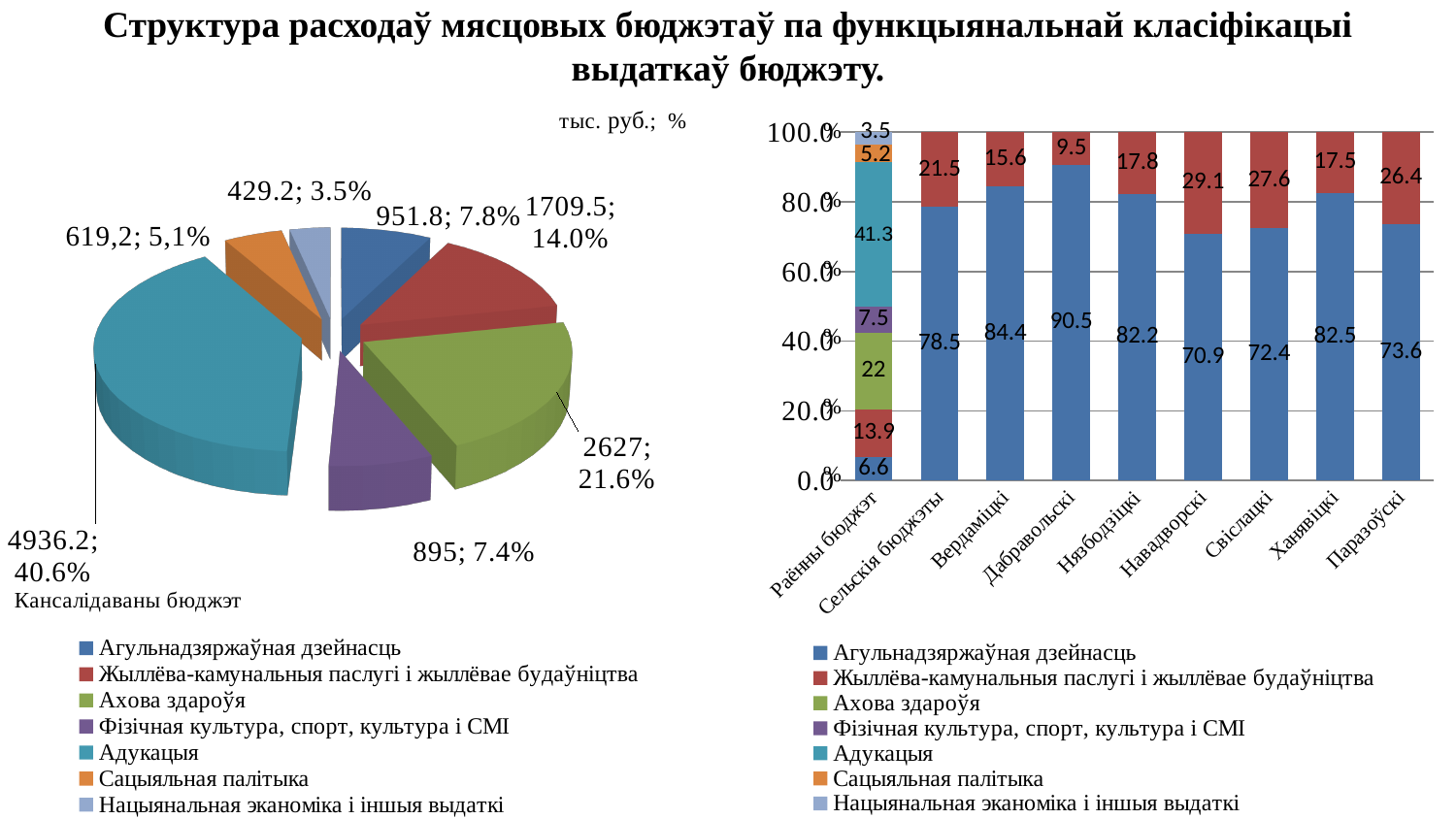
In the pie chart on the left, which category has the smallest share? Нацыянальная эканоміка і іншыя выдаткі In the bar chart on the right, what is the value of Адукацыя for Раённы бюджэт? 41.3 In the bar chart on the right, what is the value of Агульнадзяржаўная дзейнасць for Дабравольскі? 90.5 In the bar chart on the right, is the value of Агульнадзяржаўная дзейнасць for Свіслацкі larger or smaller than for Ханявіцкі? smaller In the bar chart on the right, which budget has the highest value for Агульнадзяржаўная дзейнасць? Дабравольскі In the pie chart on the left, what share of the consolidated budget goes to Адукацыя? 40.6% What type of chart is shown on the right side of the slide? stacked bar chart In the pie chart on the left, how many slices are there? 7 In the pie chart on the left, which category has the largest share? Адукацыя In the pie chart on the left, what value in thousand rubles is shown for Ахова здароўя? 2627 In the pie chart on the left, what is the difference in percentage points between the share for Жыллёва-камунальныя паслугі і жыллёвае будаўніцтва and the share for Агульнадзяржаўная дзейнасць? 6.2 In the bar chart on the right, what is the value of Жыллёва-камунальныя паслугі і жыллёвае будаўніцтва for Навадворскі? 29.1